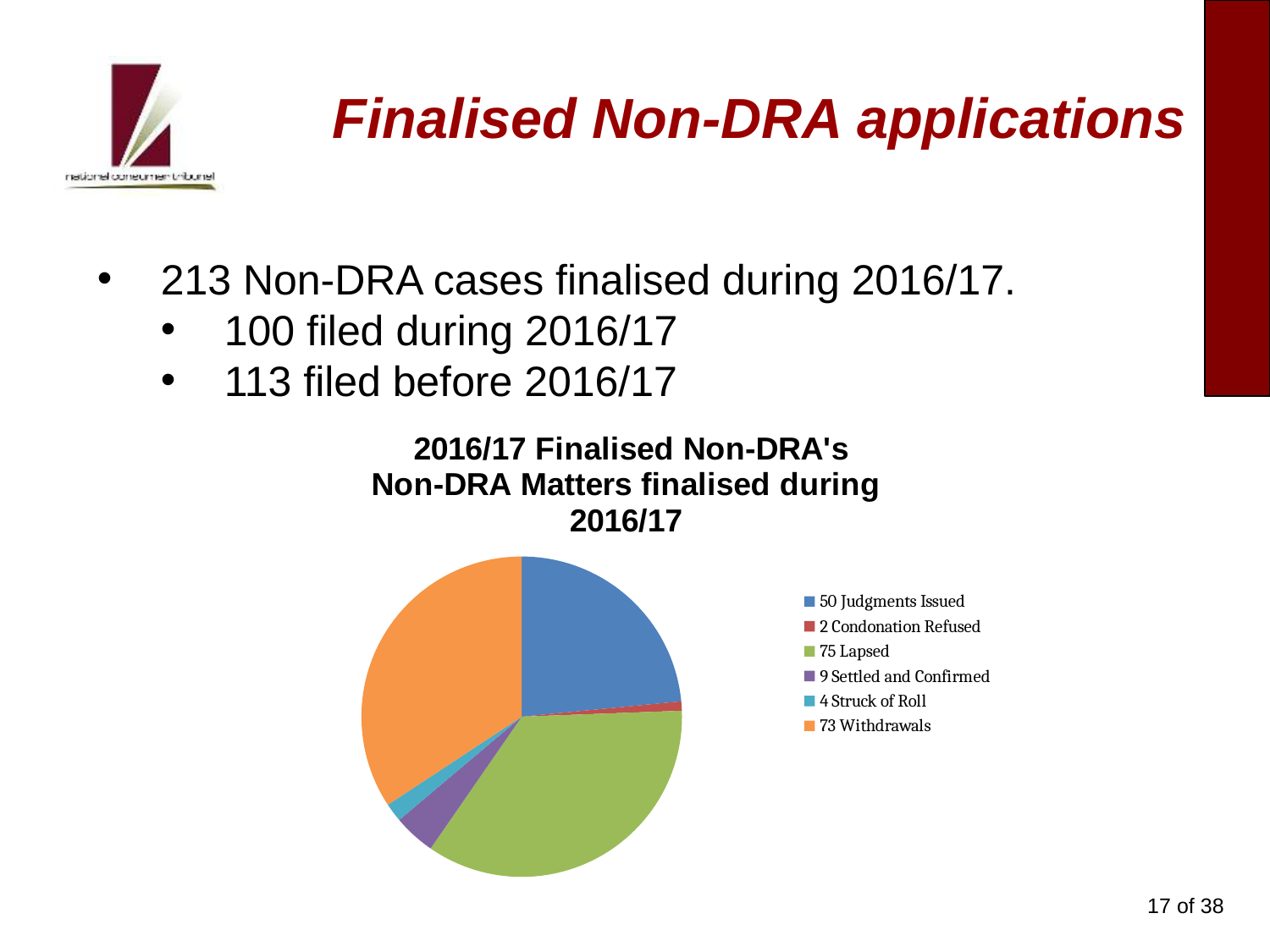
Which is larger: Judgments Issued or Withdrawals? Withdrawals What is the total of all categories in the pie chart? 213 How many Judgments Issued are shown in the pie chart? 50 How many matters are shown as Settled and Confirmed? 9 Which category has the largest value in the pie chart? Lapsed How many categories does the pie chart show? 6 What colour represents Withdrawals in the pie chart? Orange What type of chart is shown on the slide? Pie chart How many matters are shown as Lapsed in the pie chart? 75 What is the difference between the number of Lapsed matters and the number of Withdrawals? 2 How many Withdrawals are shown in the pie chart? 73 Which category has the smallest value in the pie chart? Condonation Refused